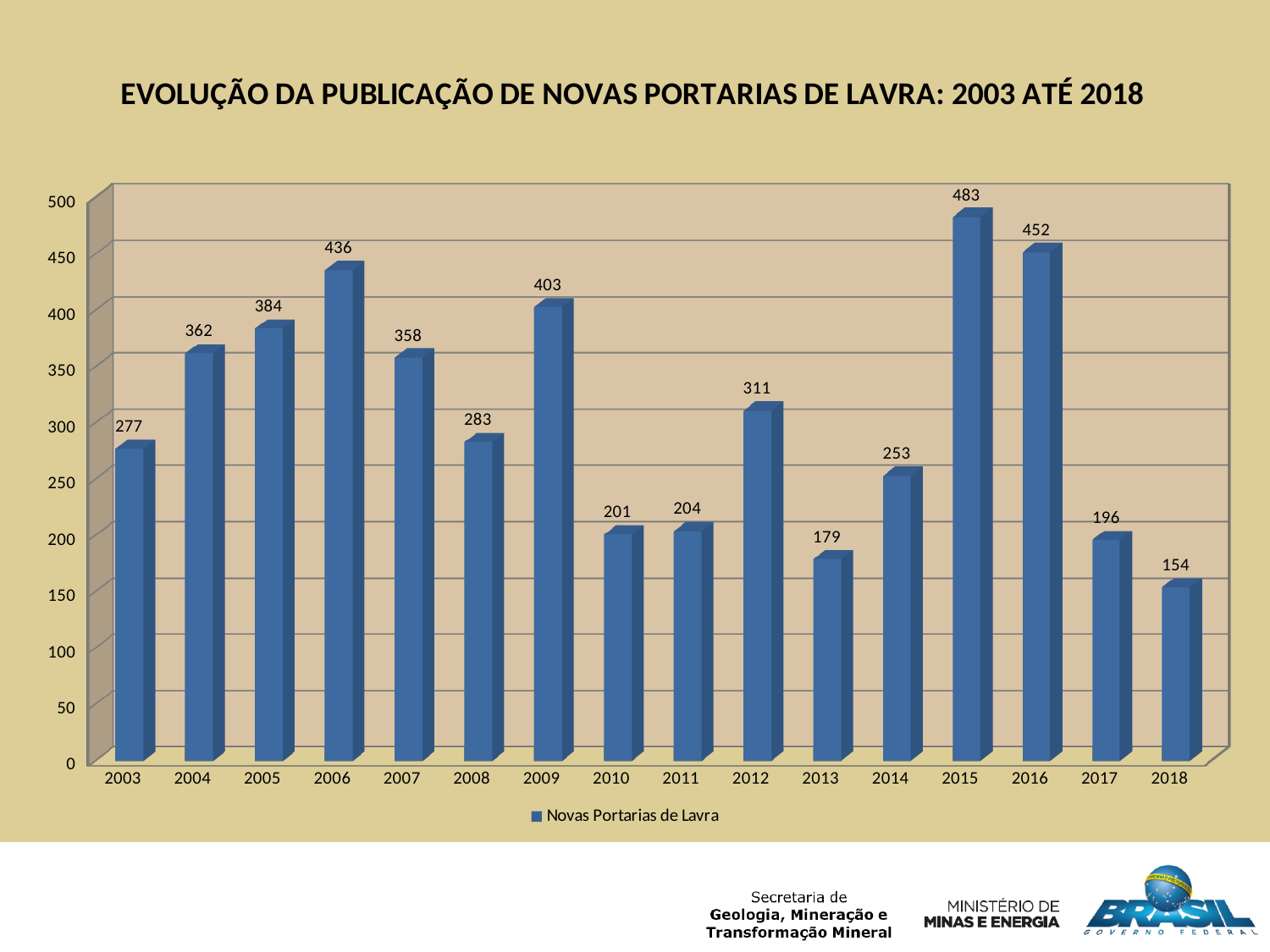
Is the value for 2012 greater or less than 300? greater What is the value for 2013? 179 Which year has the highest value? 2015 How many series does the legend list? 1 What is the value for 2006? 436 What is the legend entry for the series? Novas Portarias de Lavra What is the difference between the values for 2015 and 2016? 31 Which year has the lowest value? 2018 What kind of chart is shown? bar chart Which is larger, the value for 2004 or the value for 2007? 2004 What is the difference between the values for 2009 and 2010? 202 How many years are shown on the x axis? 16